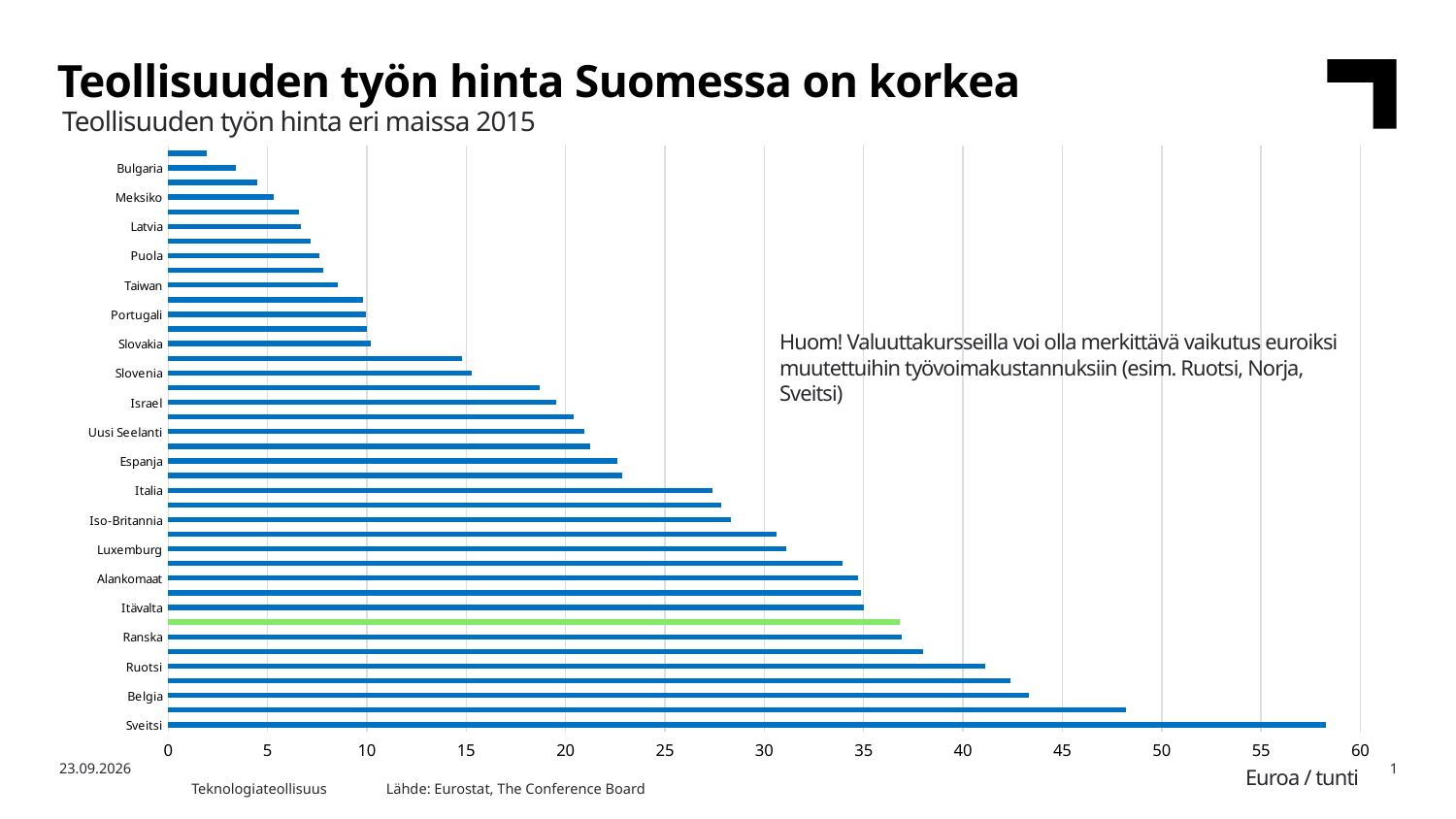
What unit is shown on the horizontal axis of the chart? Euroa / tunti Is the value for Bulgaria greater or less than 5? less Do the bar values increase or decrease going from the top of the chart to the bottom? increase Is the value for Belgia greater or less than 40? greater Which country has the highest value in the chart? Sveitsi Is the value for Iso-Britannia greater or less than 30? less Which has the larger value, Sveitsi or Belgia? Sveitsi Which has the larger value, Ranska or Italia? Ranska What kind of chart is shown on the slide? bar chart